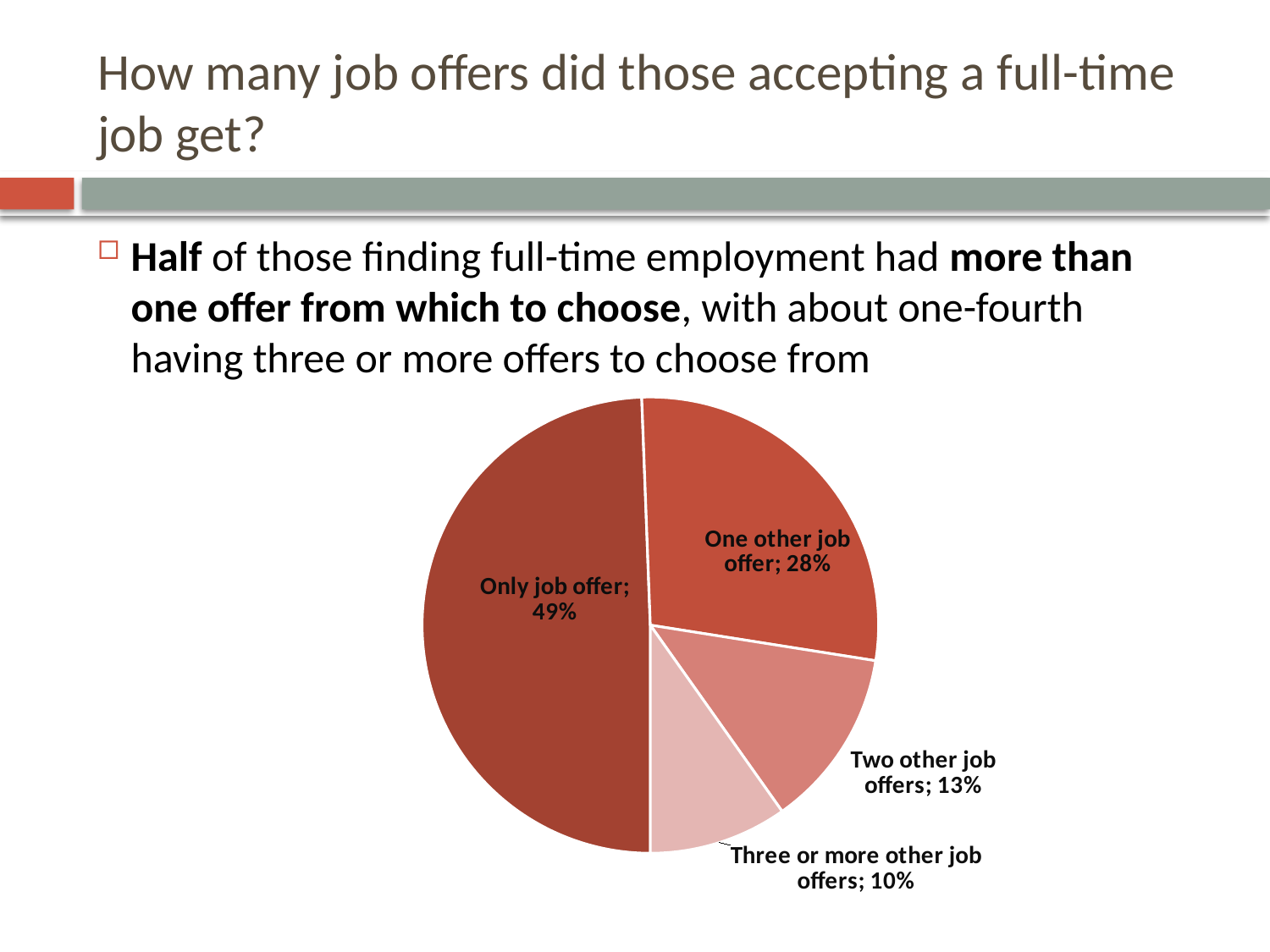
Which category has the smallest share of the pie? Three or more other job offers How many slices does the pie chart have? 4 What type of chart is shown on the slide? pie chart Which is larger: the share for 'Two other job offers' or 'Three or more other job offers'? Two other job offers What percentage of respondents had one other job offer? 28% What percentage of respondents had only one job offer? 49% What is the difference in percentage points between 'Only job offer' and 'One other job offer'? 21 What percentage of respondents had two other job offers? 13% What is the combined share of 'Two other job offers' and 'Three or more other job offers'? 23% Which category has the largest share of the pie? Only job offer What is the title of the slide containing the pie chart? How many job offers did those accepting a full-time job get? What percentage of respondents had three or more other job offers? 10%